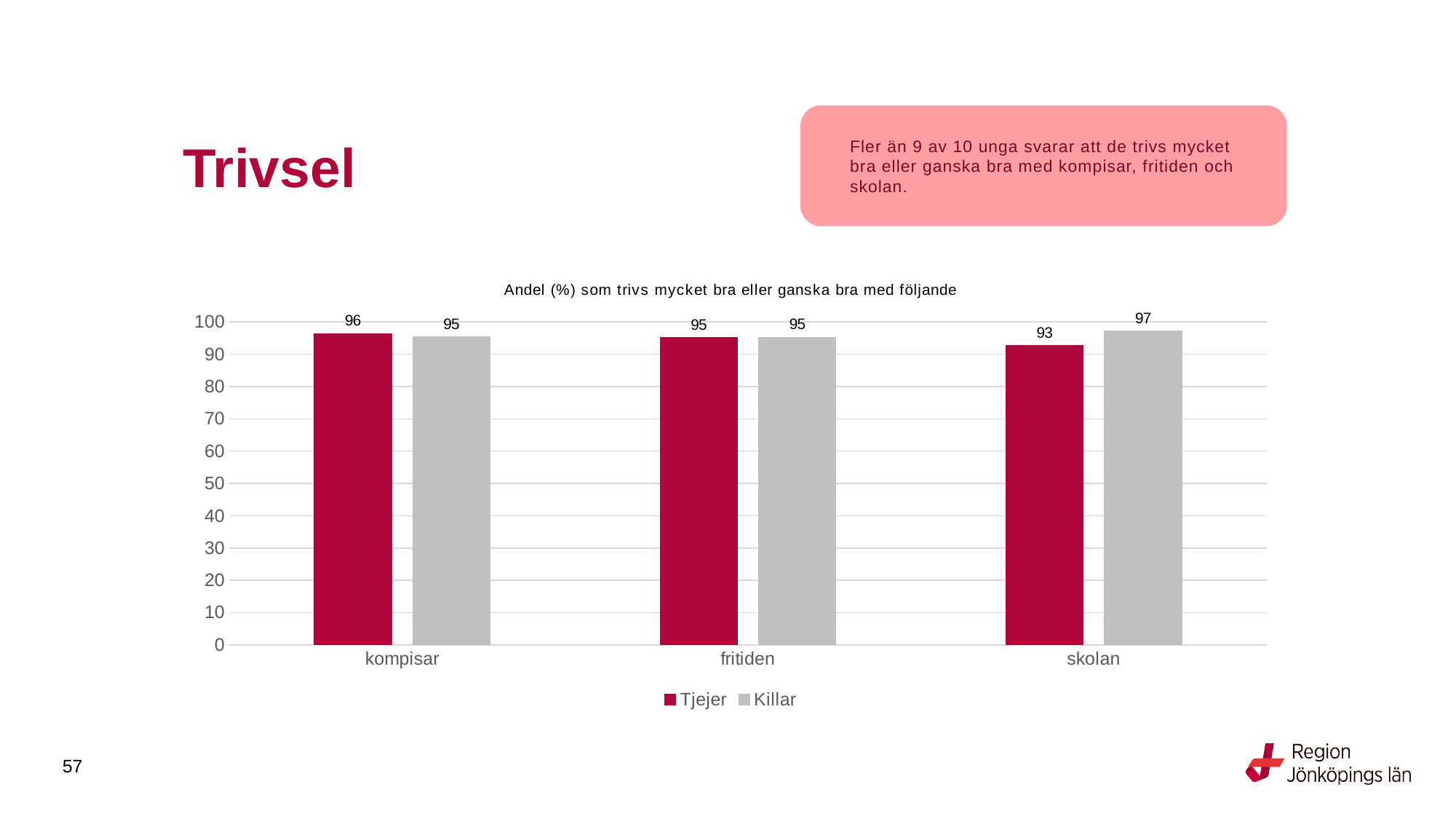
What is the value for Killar in the skolan category? 97 What kind of chart is shown on the slide? bar chart Which category has the highest value for Killar? skolan What is the difference between the Killar and Tjejer values in the skolan category? 4 In the skolan category, which series has the larger value, Tjejer or Killar? Killar What is the value for Killar in the fritiden category? 95 What is the title of the chart? Andel (%) som trivs mycket bra eller ganska bra med följande How many series does the legend list? 2 How many categories are shown on the x axis? 3 Which category has the lowest value for Tjejer? skolan What is the value for Tjejer in the kompisar category? 96 What is the value for Tjejer in the skolan category? 93